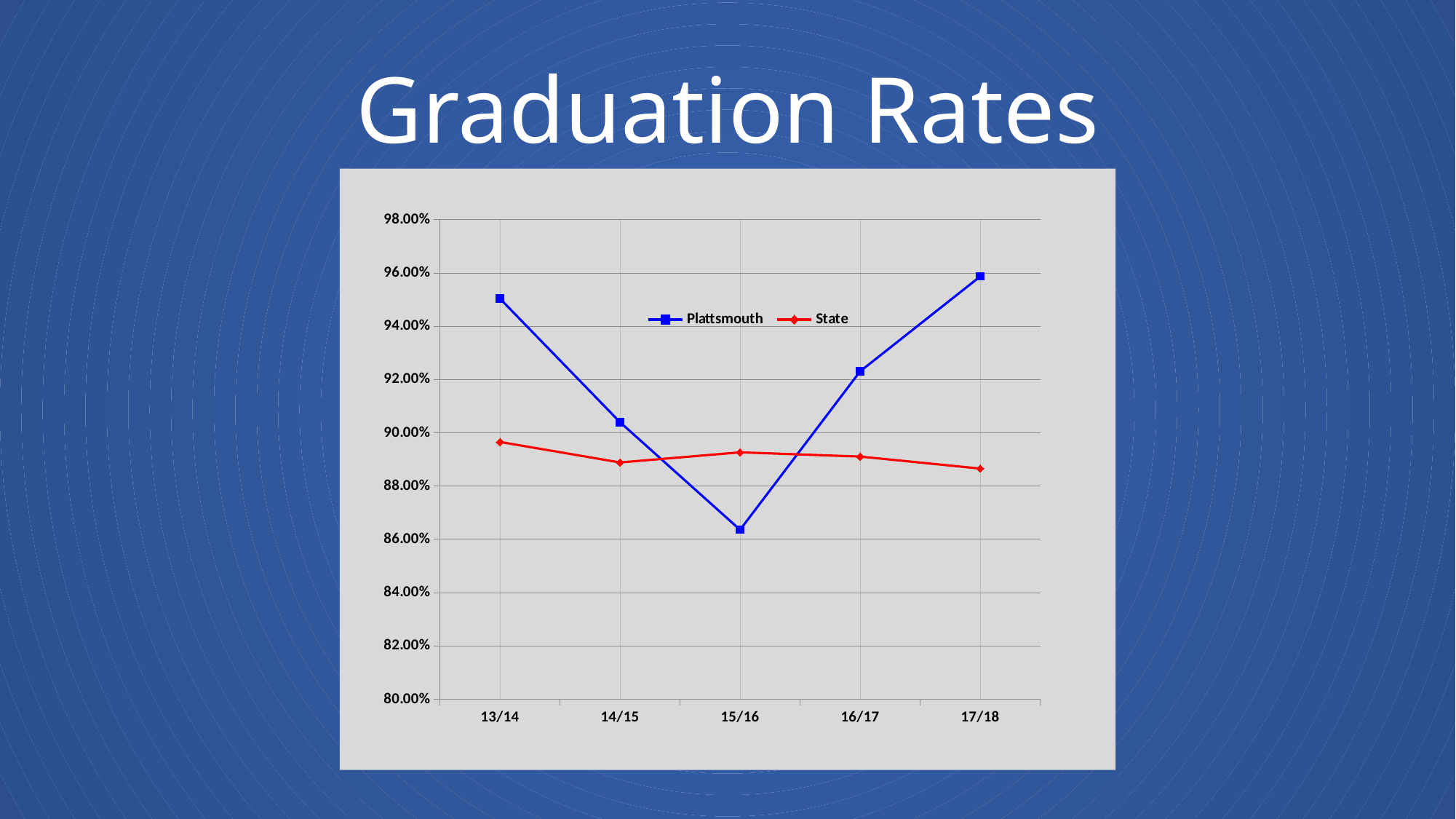
Which series has the higher value in 15/16, Plattsmouth or State? State Is the State value for 13/14 greater or less than 90.00%? less What kind of chart is shown on the slide? line chart What is the title of the slide's chart? Graduation Rates What colour is the line for the State series? red Is the Plattsmouth value for 15/16 greater or less than 88.00%? less How many series does the legend list? 2 Is the Plattsmouth value for 17/18 greater or less than 94.00%? greater How many school years are plotted along the x axis? 5 Which series has the higher value in 13/14, Plattsmouth or State? Plattsmouth In which school year is the Plattsmouth graduation rate lowest? 15/16 Does the Plattsmouth line rise or fall from 15/16 to 17/18? rise